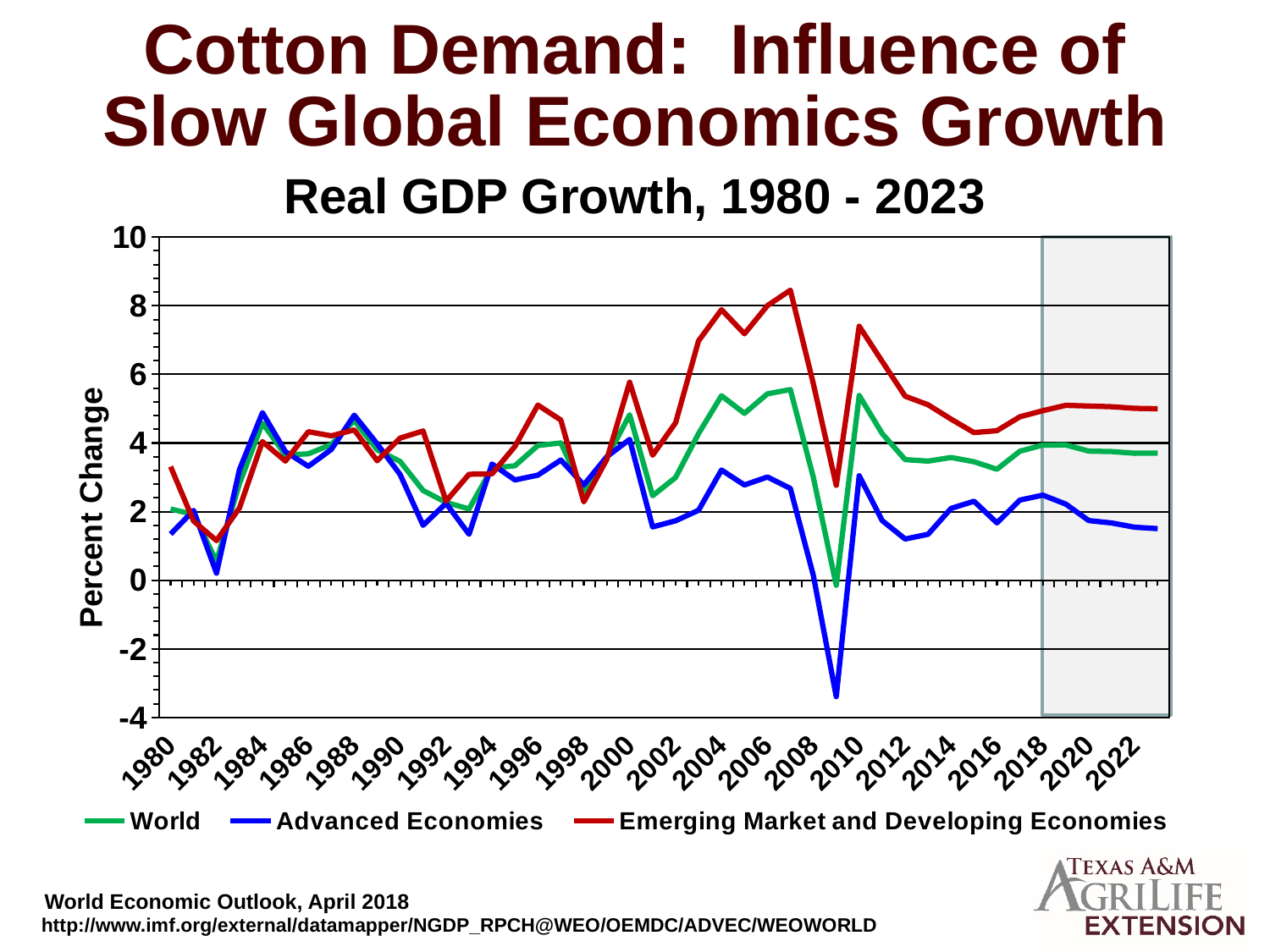
What kind of chart is shown on the slide? line chart What is the label on the vertical axis? Percent Change How many series does the legend list? 3 Is the value for World in 2009 greater or less than 2? less Is the value for Advanced Economies in 2009 greater or less than -2? less Is the value for Emerging Market and Developing Economies in 2022 greater or less than 4? greater In which year does the Advanced Economies series reach its lowest value? 2009 In 2009, which series has the higher value: Emerging Market and Developing Economies or Advanced Economies? Emerging Market and Developing Economies In which year does the Emerging Market and Developing Economies series reach its highest value? 2007 What is the title of the chart? Real GDP Growth, 1980 - 2023